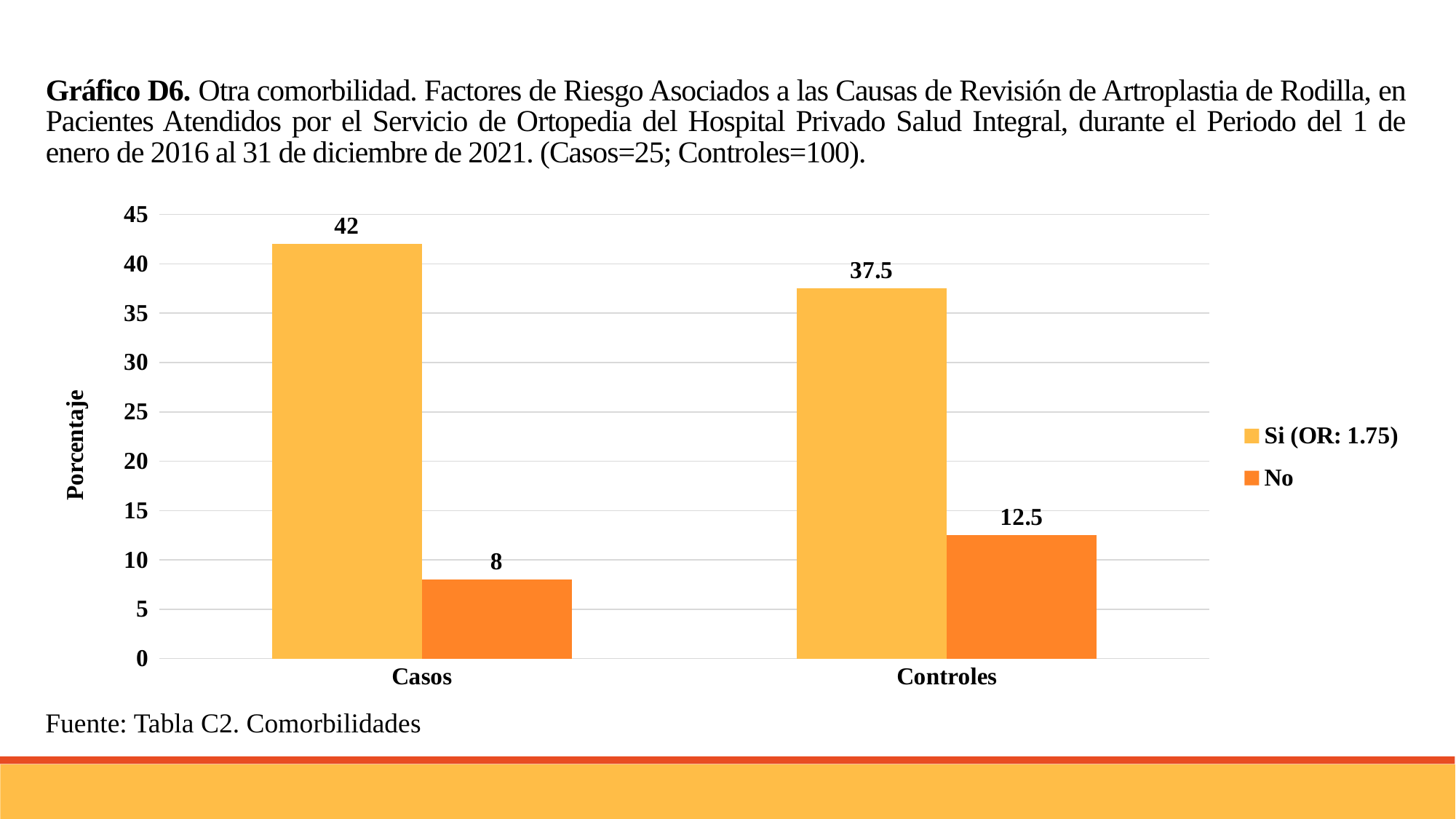
How many series does the legend list? 2 How many categories are shown on the x axis? 2 Which category has the highest 'Si (OR: 1.75)' value? Casos What is the label of the y axis? Porcentaje What is the value of the 'Si (OR: 1.75)' series for Controles? 37.5 What is the value of the 'Si (OR: 1.75)' series for Casos? 42 What kind of chart is shown on the slide? Bar chart Which is larger: the 'No' value for Casos or the 'No' value for Controles? Controles What is the value of the 'No' series for Controles? 12.5 What is the value of the 'No' series for Casos? 8 What is the difference between the 'Si (OR: 1.75)' values for Casos and Controles? 4.5 Which category has the lowest 'No' value? Casos